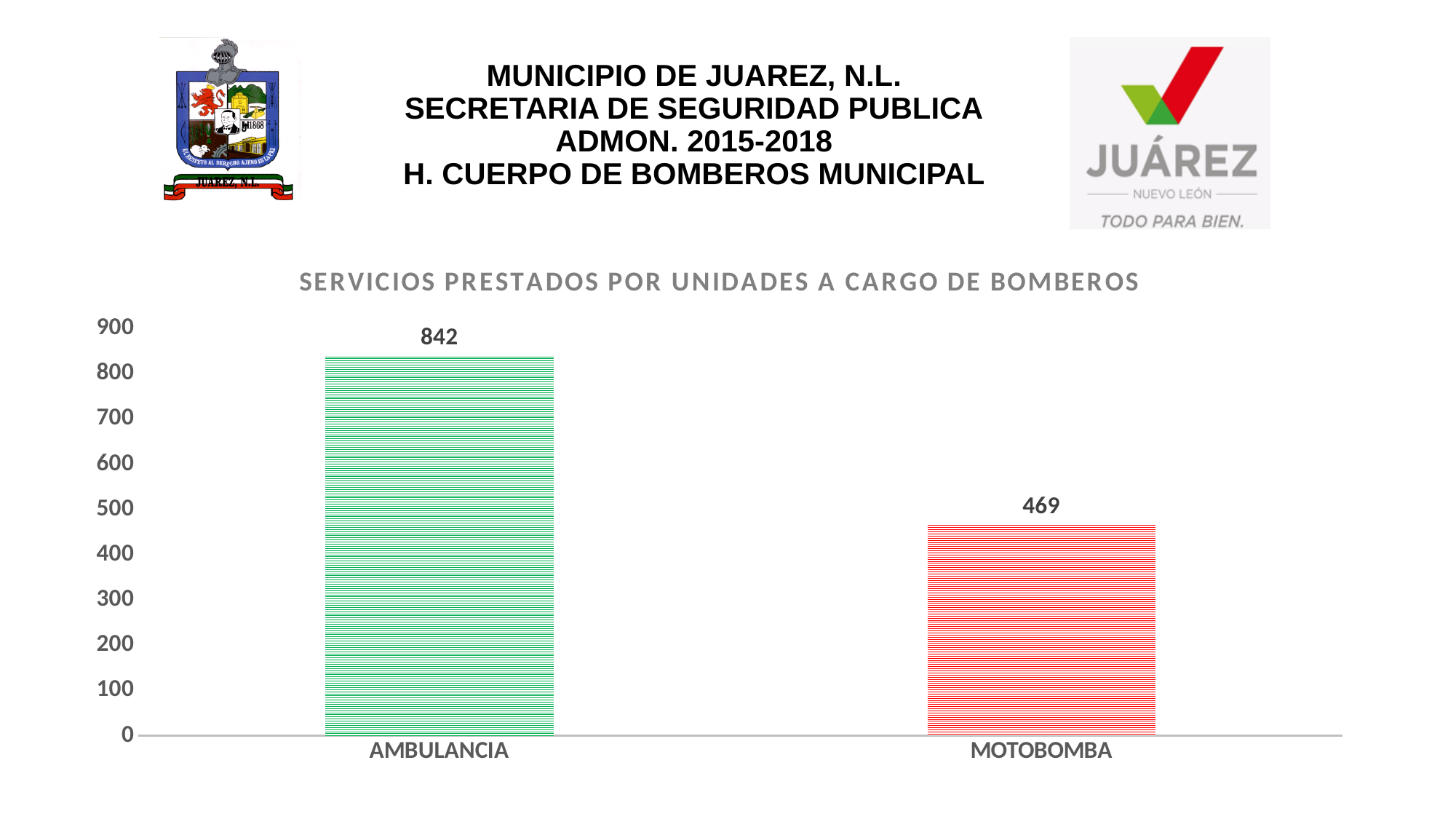
Which category has the highest value? AMBULANCIA Is the value for MOTOBOMBA greater or less than 500? less What is the value for MOTOBOMBA? 469 What is the difference between the values for AMBULANCIA and MOTOBOMBA? 373 What colour is the bar for MOTOBOMBA? red What is the title of the chart? SERVICIOS PRESTADOS POR UNIDADES A CARGO DE BOMBEROS Which category has the lowest value? MOTOBOMBA How many categories are shown on the chart? 2 Is the value for AMBULANCIA greater or less than 800? greater What is the value for AMBULANCIA? 842 Which is larger, the value for AMBULANCIA or the value for MOTOBOMBA? AMBULANCIA What kind of chart is shown on the slide? bar chart